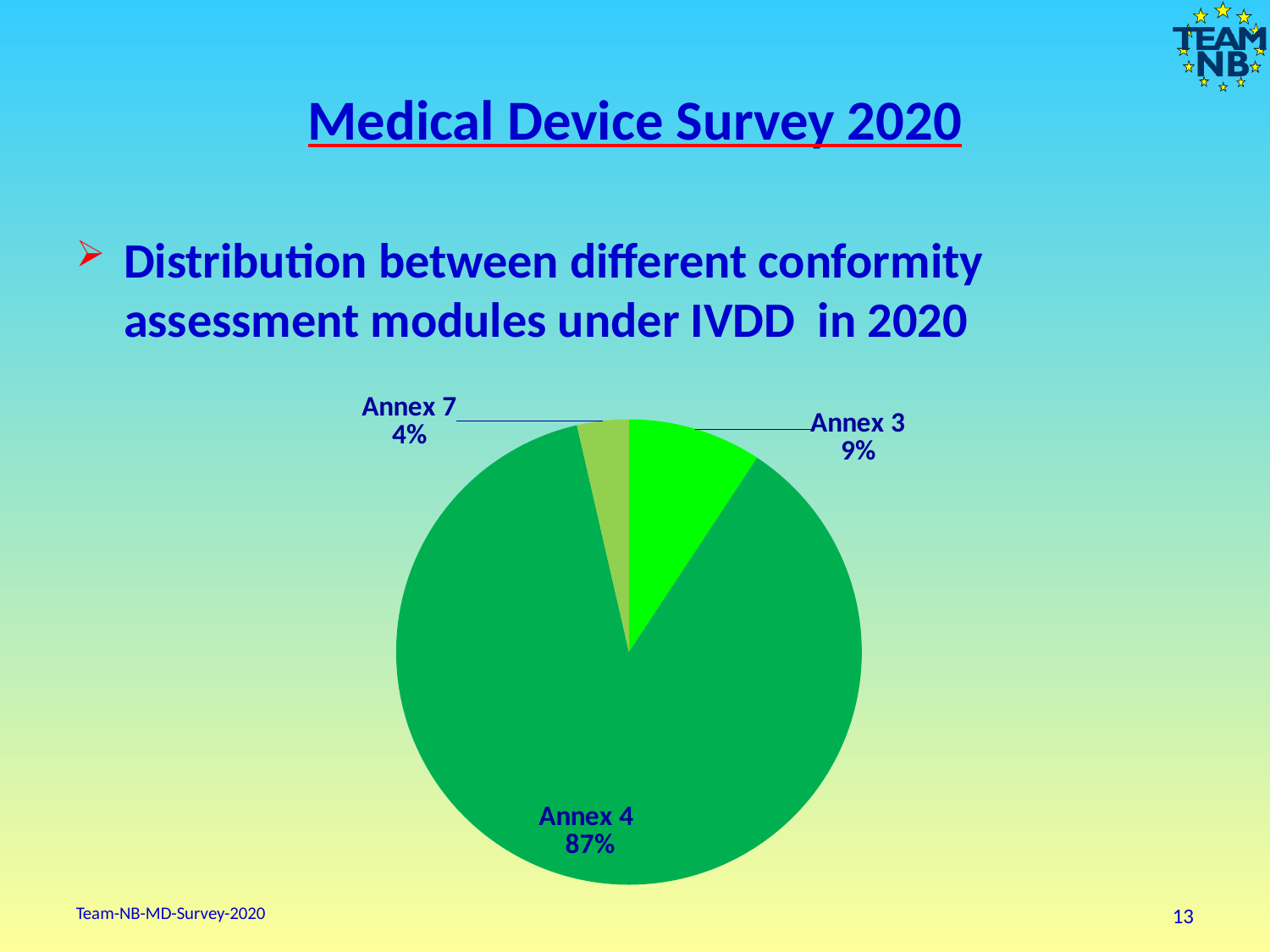
What is the combined share of Annex 3 and Annex 7? 13% What is the difference in percentage points between the shares of Annex 4 and Annex 3? 78 What does the chart show, according to the bullet text above it? Distribution between different conformity assessment modules under IVDD in 2020 What share of the pie does Annex 4 represent? 87% What is the difference in percentage points between the shares of Annex 3 and Annex 7? 5 What share of the pie does Annex 7 represent? 4% Which has a larger share, Annex 3 or Annex 7? Annex 3 What share of the pie does Annex 3 represent? 9% Which annex has the largest share of the pie? Annex 4 What kind of chart is shown on the slide? Pie chart How many slices does the pie chart have? 3 Which annex has the smallest share of the pie? Annex 7